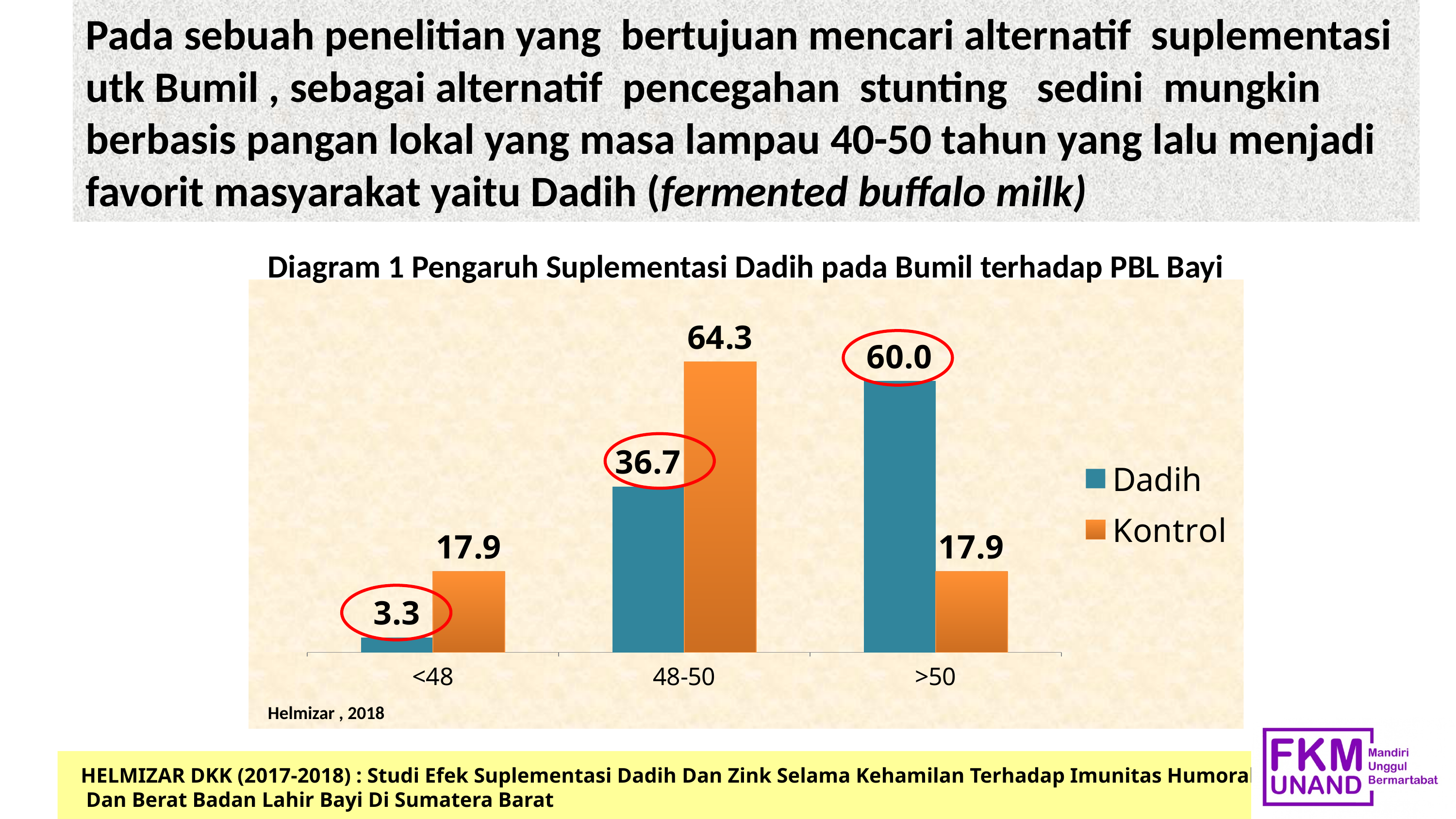
Do the Dadih values rise or fall from <48 to >50? Rise What is the value for Dadih in the >50 category? 60.0 How many series does the legend list? 2 What is the value for Kontrol in the >50 category? 17.9 Which is larger in the >50 category, Dadih or Kontrol? Dadih In which category is the Dadih value highest? >50 What kind of chart is shown? Bar chart What is the value for Dadih in the <48 category? 3.3 How many categories are shown on the x axis? 3 What is the difference between the Kontrol and Dadih values in the 48-50 category? 27.6 In which category is the Dadih value lowest? <48 What is the value for Kontrol in the 48-50 category? 64.3